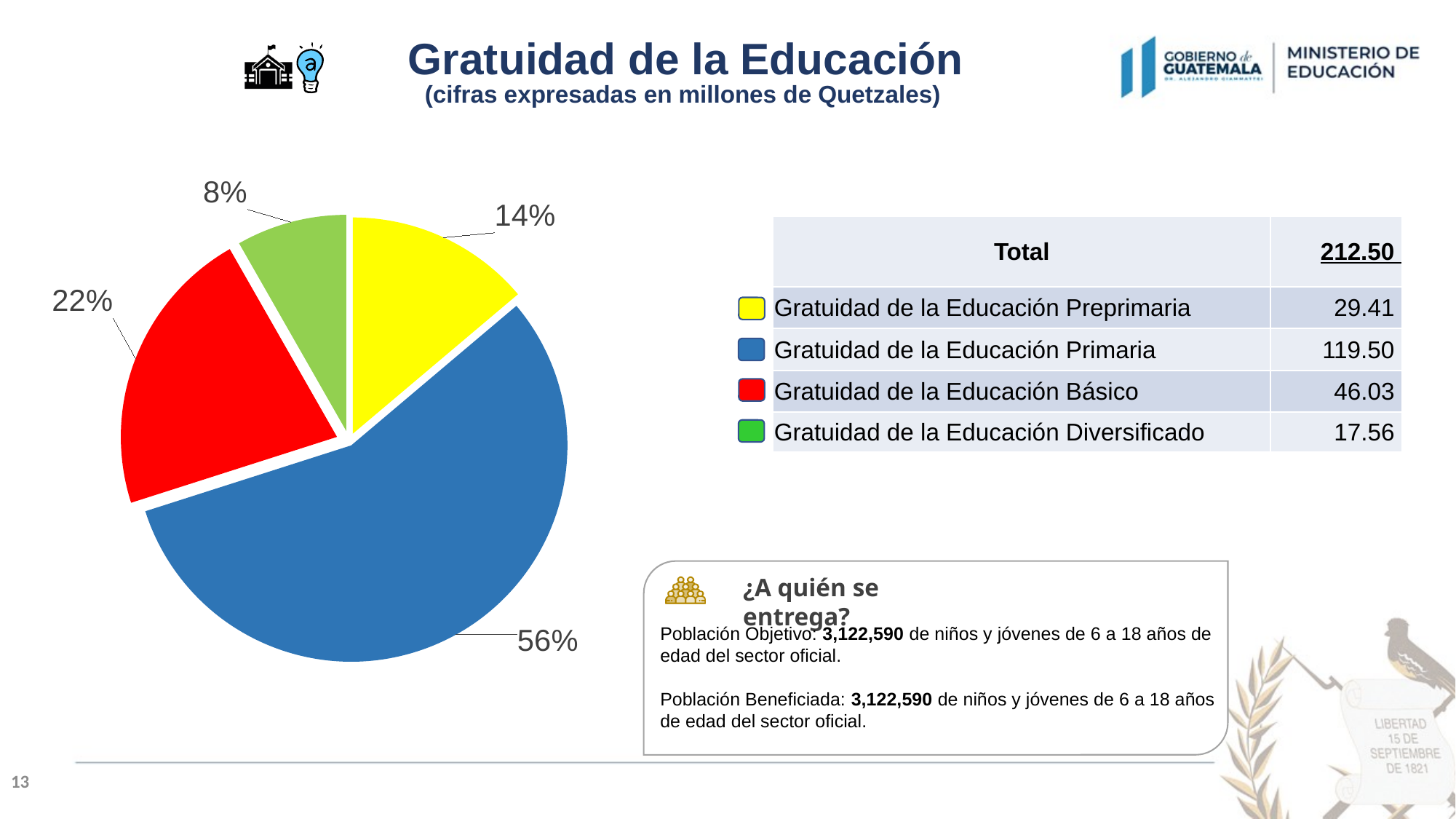
What type of chart is shown on the slide? pie chart Which category has the largest slice of the pie? Gratuidad de la Educación Primaria What share of the pie does the green slice (Gratuidad de la Educación Diversificado) represent? 8% What share of the pie does the yellow slice (Gratuidad de la Educación Preprimaria) represent? 14% How many slices does the pie chart have? 4 What share of the pie does the red slice (Gratuidad de la Educación Básico) represent? 22% What is the total value shown for all categories in millions of Quetzales? 212.50 Which category has the smallest slice of the pie? Gratuidad de la Educación Diversificado What is the value for Gratuidad de la Educación Básico in millions of Quetzales? 46.03 Which colour represents Gratuidad de la Educación Diversificado in the pie chart? green What is the difference between the values for Gratuidad de la Educación Primaria and Gratuidad de la Educación Básico? 73.47